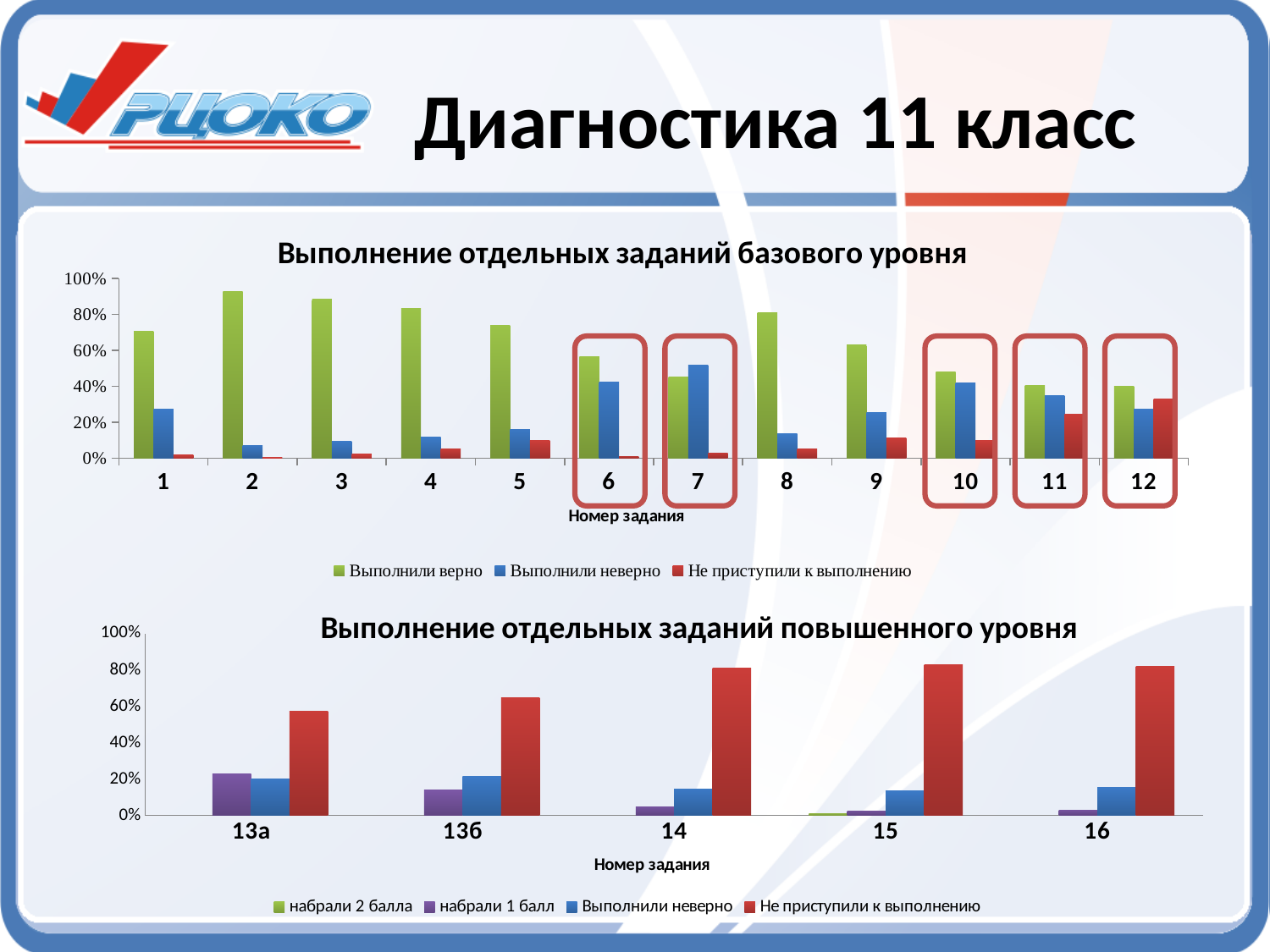
In the top chart "Выполнение отдельных заданий базового уровня", is the "Выполнили верно" value for task 1 greater or less than 60%? greater In the top chart "Выполнение отдельных заданий базового уровня", which task has the highest value for "Выполнили неверно"? 7 In the top chart "Выполнение отдельных заданий базового уровня", which task has the highest value for "Выполнили верно"? 2 In the bottom chart "Выполнение отдельных заданий повышенного уровня", which task has the lowest value for "Не приступили к выполнению"? 13а How many task numbers are shown on the x axis of the top chart "Выполнение отдельных заданий базового уровня"? 12 What kind of chart is the top chart titled "Выполнение отдельных заданий базового уровня"? bar chart How many series does the legend of the bottom chart "Выполнение отдельных заданий повышенного уровня" list? 4 In the top chart "Выполнение отдельных заданий базового уровня", which task has the highest value for "Не приступили к выполнению"? 12 In the top chart "Выполнение отдельных заданий базового уровня", for task 7, which is larger: "Выполнили верно" or "Выполнили неверно"? Выполнили неверно In the bottom chart "Выполнение отдельных заданий повышенного уровня", is the "Не приступили к выполнению" value for task 14 greater or less than 60%? greater How many task numbers are shown on the x axis of the bottom chart "Выполнение отдельных заданий повышенного уровня"? 5 How many series does the legend of the top chart "Выполнение отдельных заданий базового уровня" list? 3